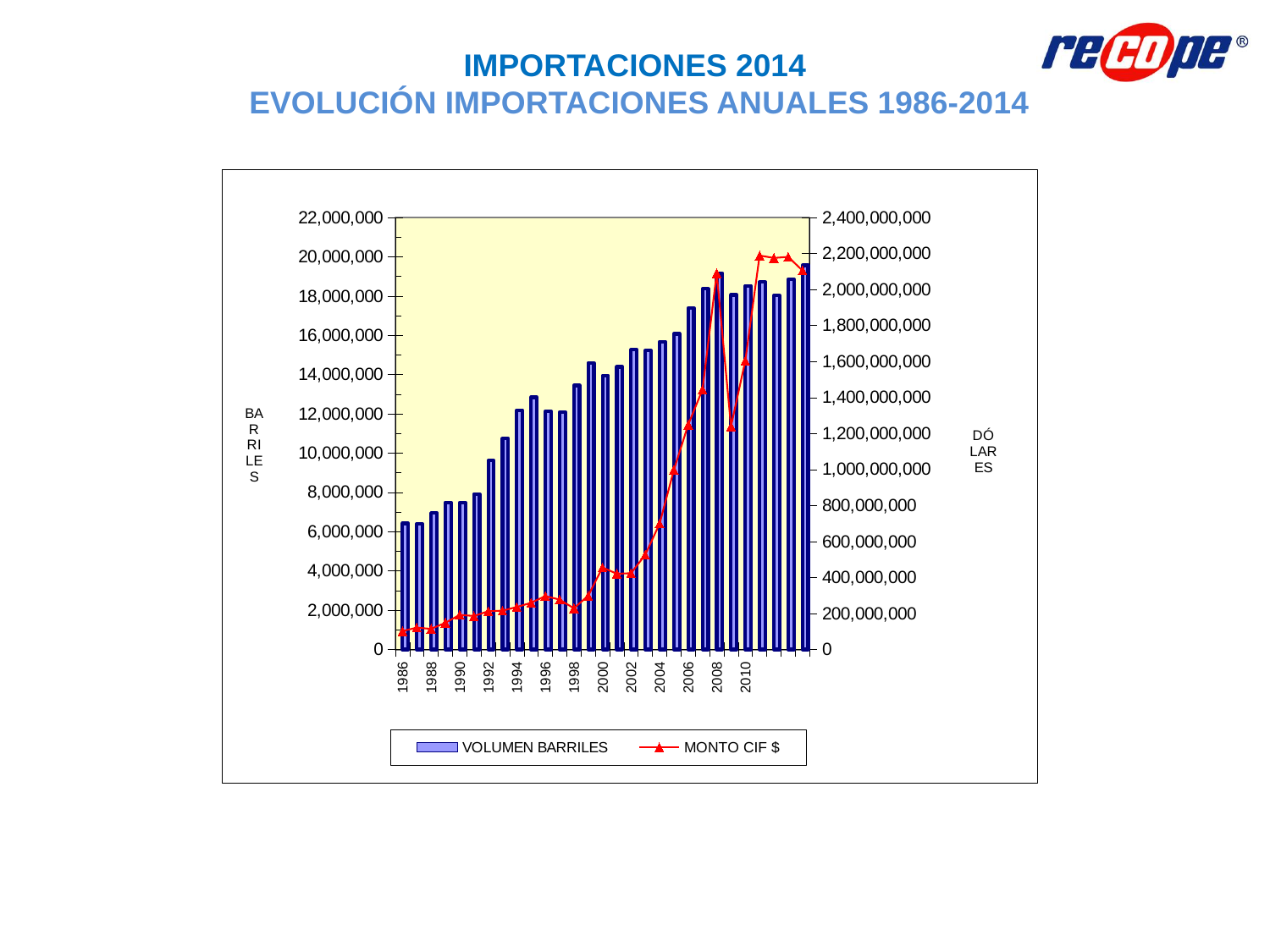
Is the VOLUMEN BARRILES value for 2008 greater or less than 18,000,000? greater Overall, do the VOLUMEN BARRILES values rise or fall from 1986 to 2014? rise Is the MONTO CIF $ value for 1986 greater or less than 200,000,000? less How many series does the legend list? 2 Which year has the larger VOLUMEN BARRILES value, 2000 or 2006? 2006 What are the two series named in the legend? VOLUMEN BARRILES and MONTO CIF $ How many years (bars) are plotted in the chart? 29 Is the MONTO CIF $ value for 2008 greater or less than 2,000,000,000? greater What kind of chart is shown on the slide? A bar chart combined with a line chart Which year has the larger MONTO CIF $ value, 2008 or 2009? 2008